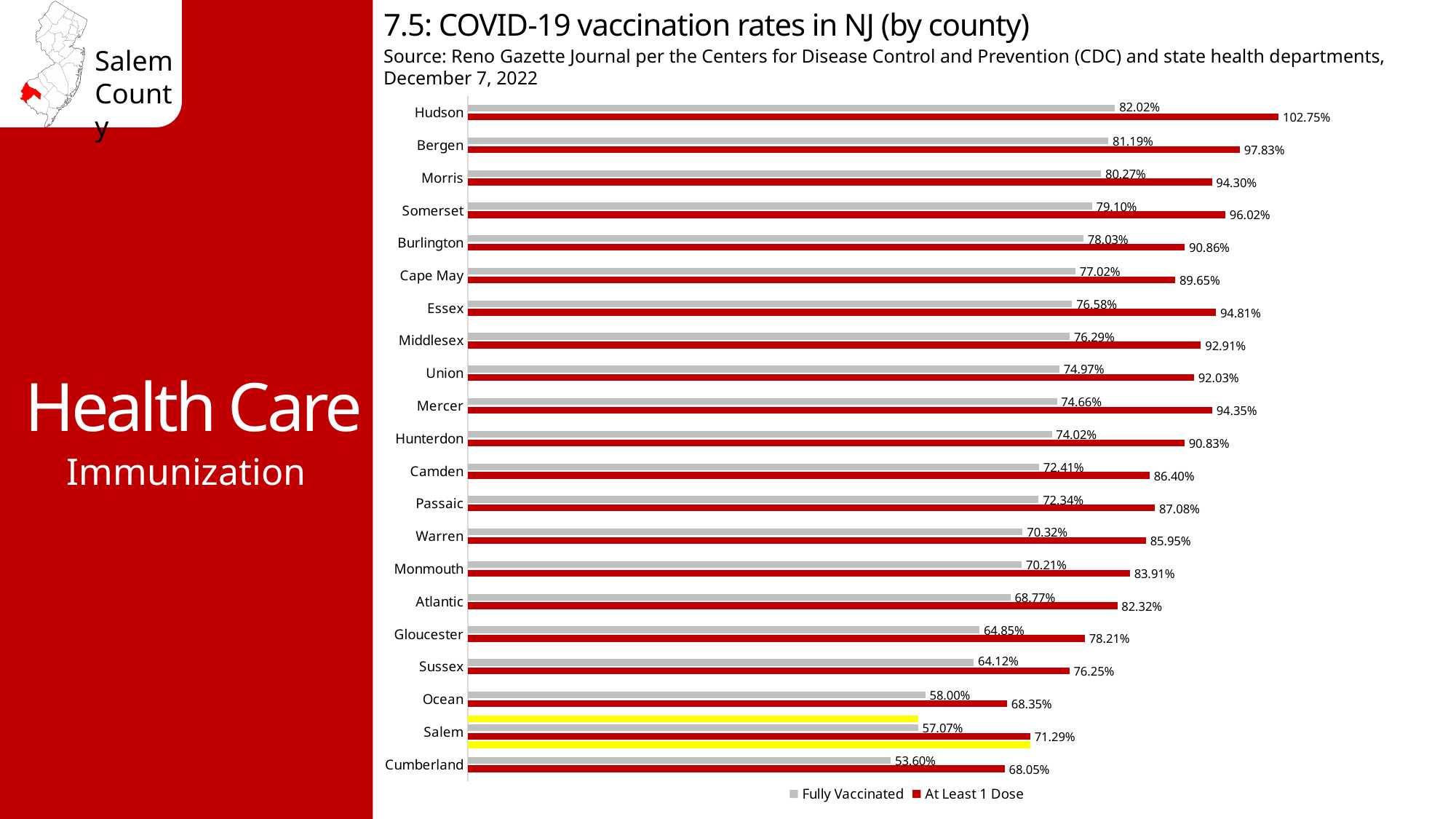
How many series does the legend list? 2 How many counties are shown in the chart? 21 What is the At Least 1 Dose rate for Cumberland County? 68.05% What is the difference between the At Least 1 Dose rate and the Fully Vaccinated rate for Salem County? 14.22 percentage points Which county has the highest Fully Vaccinated rate? Hudson What is the Fully Vaccinated rate for Salem County? 57.07% What is the At Least 1 Dose rate for Hudson County? 102.75% Which is larger: the At Least 1 Dose rate for Ocean County or for Salem County? Salem County Which county has the lowest Fully Vaccinated rate? Cumberland Which series is shown in red in the chart? At Least 1 Dose What kind of chart is shown on the slide? Bar chart What is the Fully Vaccinated rate for Mercer County? 74.66%